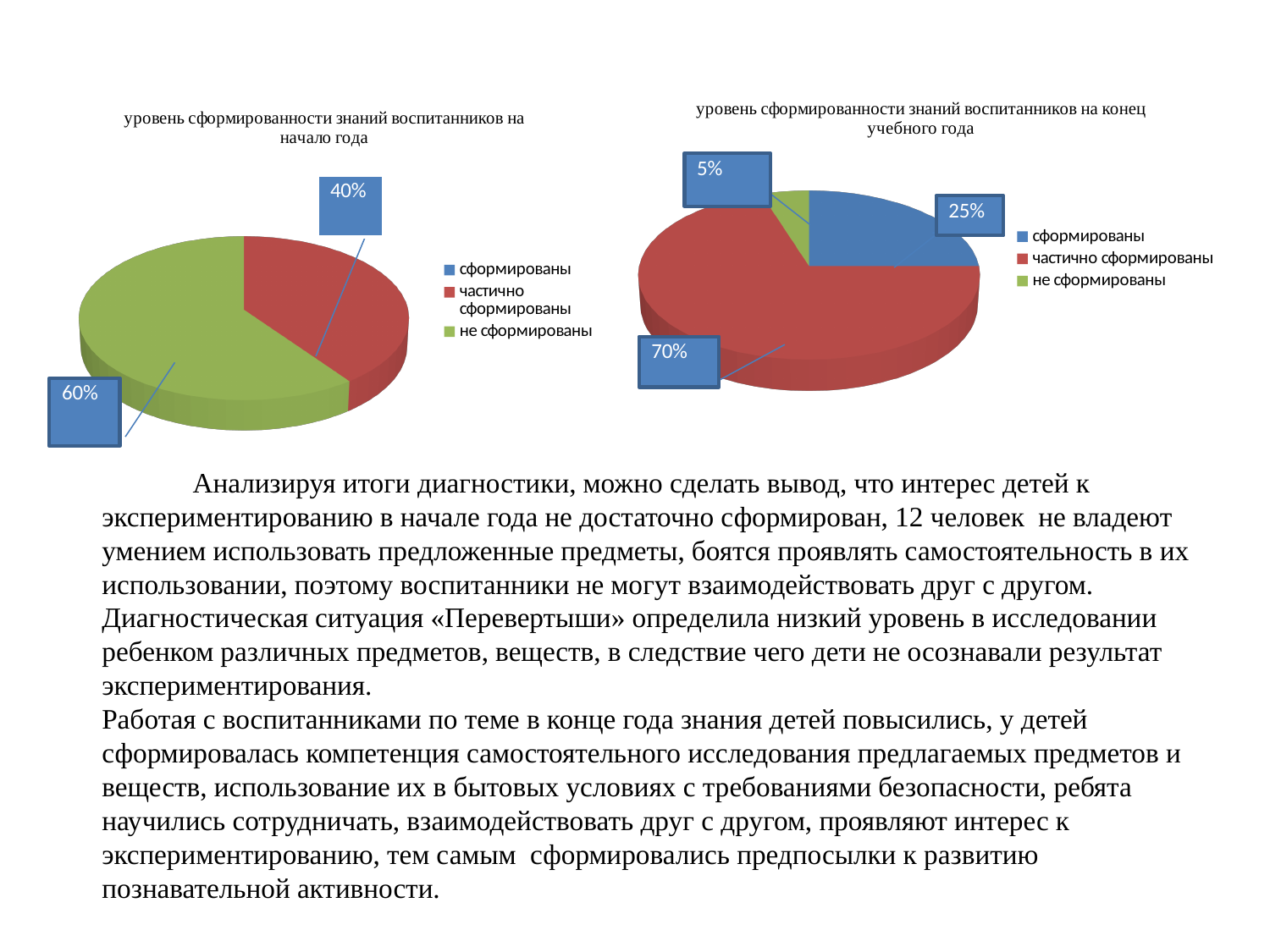
In the left chart (на начало года), what is the difference between the shares of 'не сформированы' and 'частично сформированы'? 20% What type of chart is used on this slide? Pie chart In the right chart (на конец учебного года), which category has the smallest share? не сформированы In the right chart (на конец учебного года), what percentage is shown for 'сформированы'? 25% In the right chart (на конец учебного года), what percentage is shown for 'не сформированы'? 5% In the right chart (на конец учебного года), which category has the largest share? частично сформированы In the left chart (на начало года), what percentage is shown for 'частично сформированы'? 40% How many entries does the legend of the right chart (на конец учебного года) list? 3 In the right chart (на конец учебного года), what percentage is shown for 'частично сформированы'? 70% In the left chart (на начало года), which category has the largest share? не сформированы In the right chart (на конец учебного года), what is the difference between the shares of 'частично сформированы' and 'сформированы'? 45% In the left chart (на начало года), what percentage is shown for 'не сформированы'? 60%